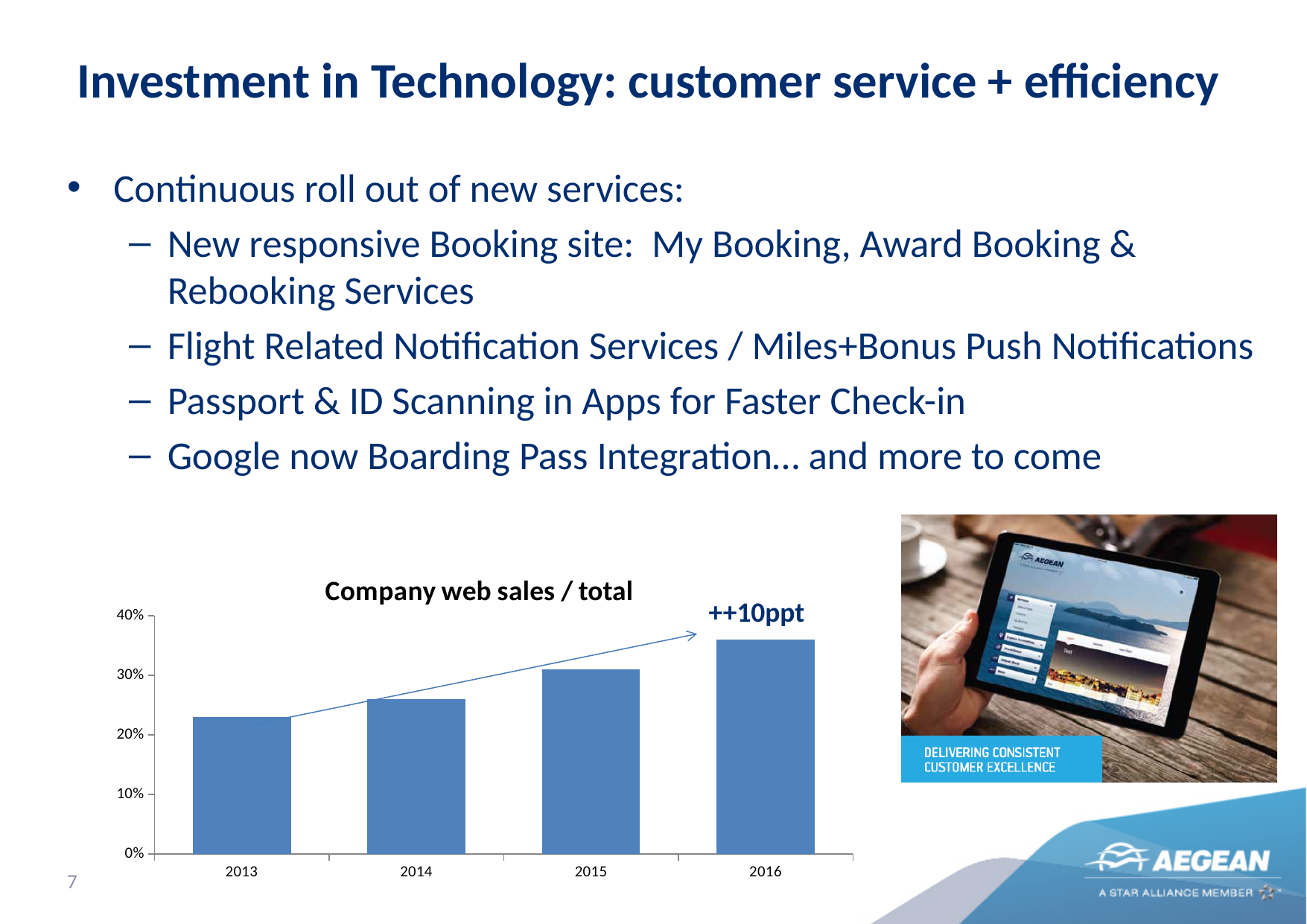
Is the value for 2013 greater or less than 30%? less How many years are plotted on the chart? 4 Is the value for 2016 greater or less than 40%? less What type of chart is shown on the slide? bar chart Is the value for 2013 greater or less than 20%? greater Which is larger, the value for 2015 or the value for 2014? 2015 What annotation is written next to the arrow above the bars? ++10ppt Do the values rise or fall from 2013 to 2016? rise What is the title of the chart? Company web sales / total Which year has the lowest company web sales / total? 2013 Which year has the highest company web sales / total? 2016